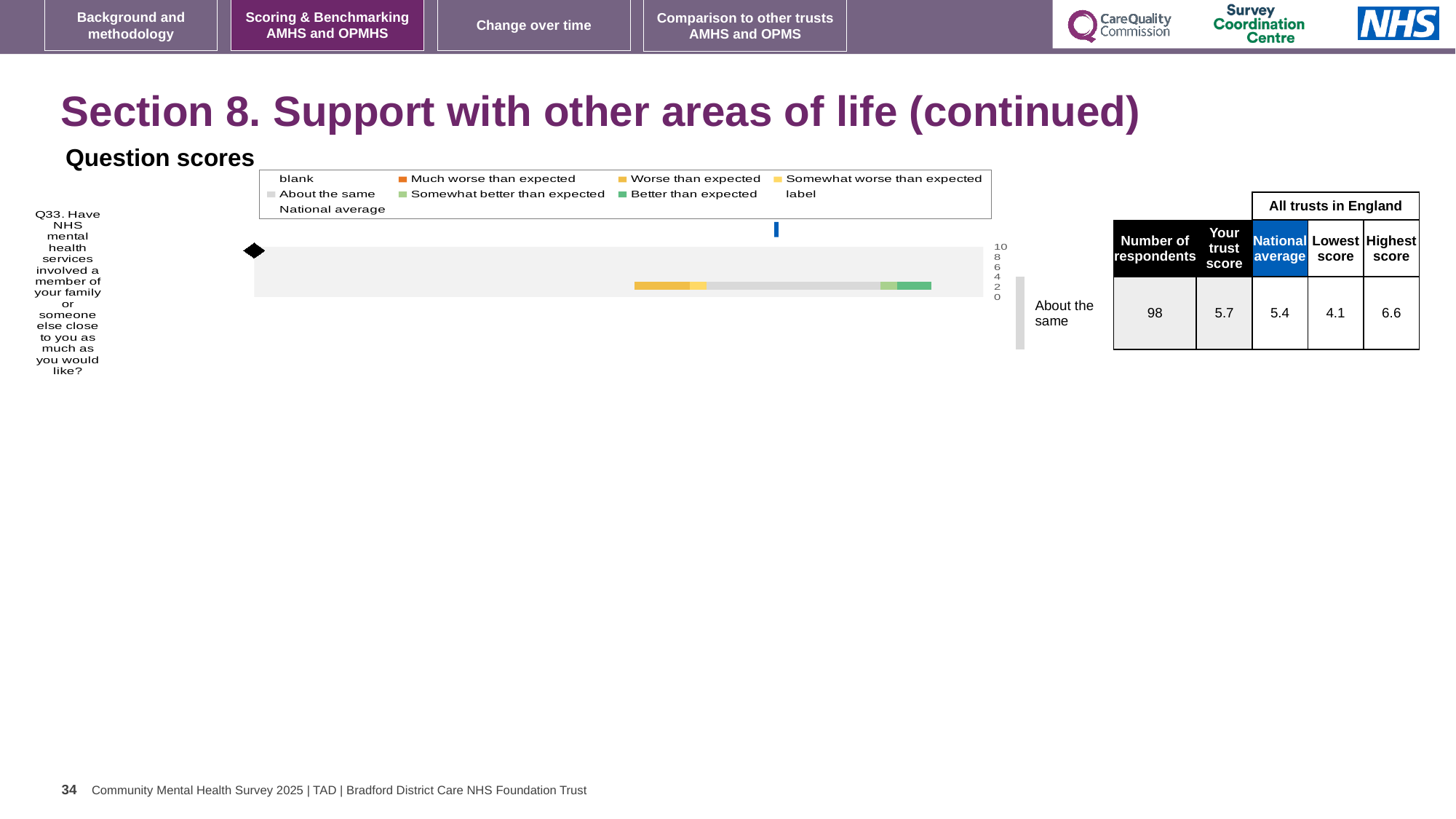
In the table beside the chart, what is the lowest score among all trusts in England for Q33? 4.1 What kind of chart is shown under 'Question scores'? bar chart Which question is plotted in the chart? Q33. Have NHS mental health services involved a member of your family or someone else close to you as much as you would like? For Q33, which is larger: your trust score or the national average? Your trust score How many questions (categories) are plotted in the chart? 1 Which legend entry is shown in grey? About the same What benchmark category label is shown to the right of the bar for Q33? About the same In the table beside the chart, what is the number of respondents for Q33? 98 In the table beside the chart, what is the national average for Q33? 5.4 In the table beside the chart, what is 'Your trust score' for Q33? 5.7 How many entries does the chart legend list? 9 In the table beside the chart, what is the highest score among all trusts in England for Q33? 6.6